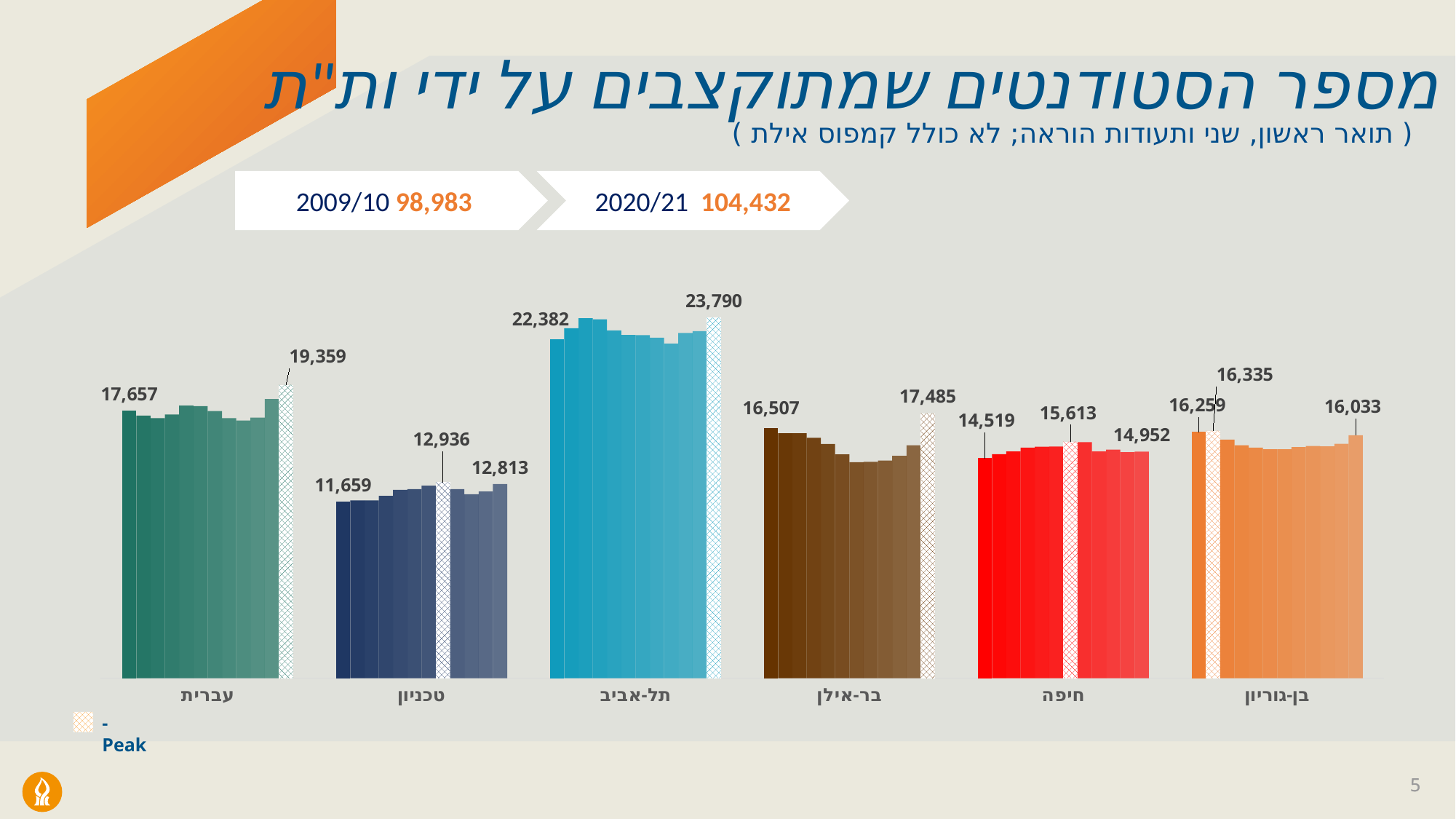
Which university has the lowest number of students in the chart? טכניון What kind of chart is shown on the slide? Bar chart Which university has the highest number of students in the chart? תל-אביב How many universities are shown on the x axis of the chart? 6 What is the 2020/21 value shown for בן-גוריון? 16,033 What is the peak value labelled for טכניון? 12,936 What is the peak value labelled for חיפה? 15,613 What is the 2020/21 value shown for עברית? 19,359 What is the difference between the 2020/21 value and the 2009/10 value for בר-אילן? 978 Which is larger: the 2020/21 value for עברית or the 2020/21 value for בר-אילן? עברית What does the hatched bar pattern in the legend represent? Peak What is the 2009/10 value shown for תל-אביב? 22,382